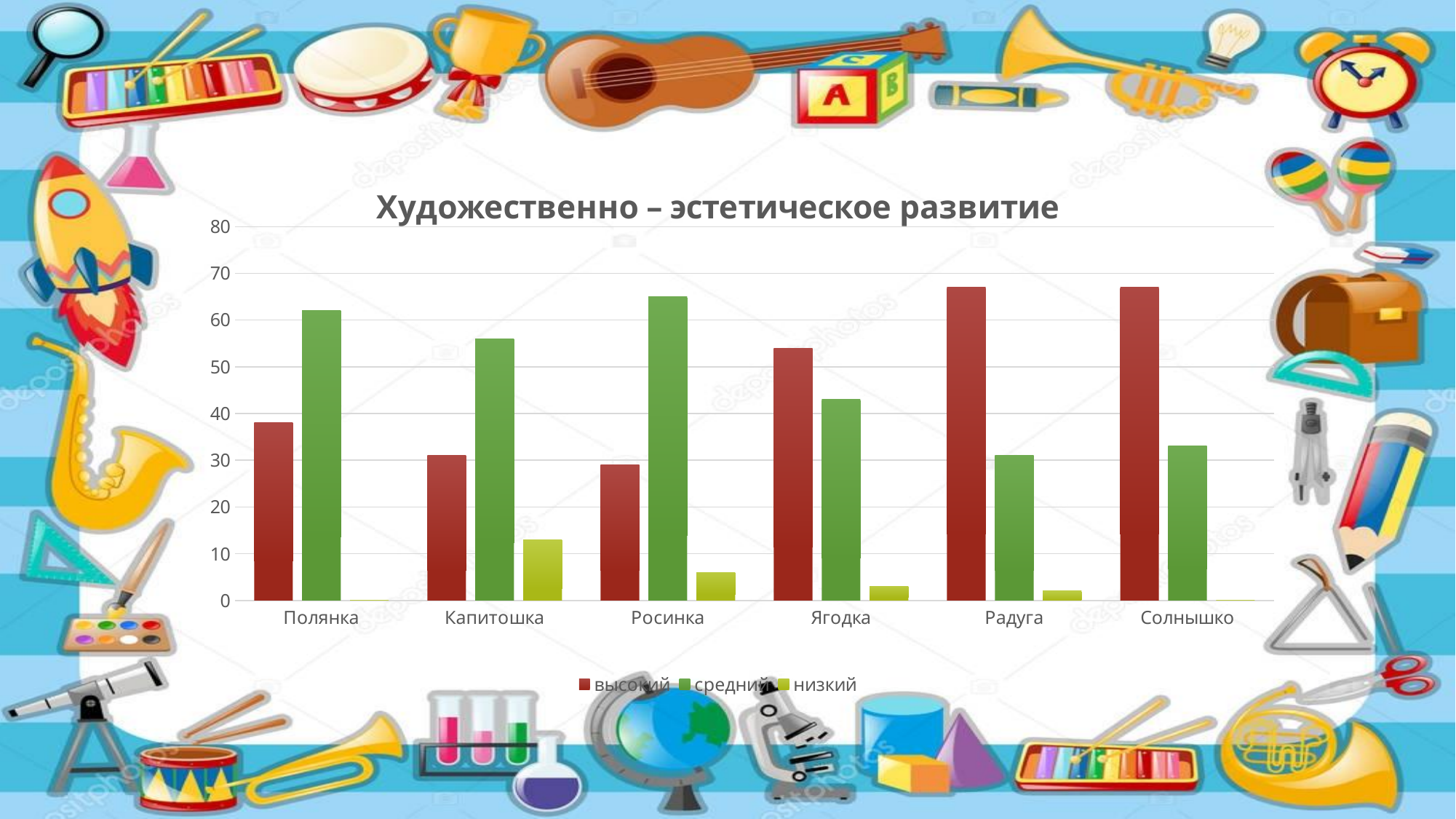
Is the value for высокий in Росинка greater or less than 40? less Is the value for высокий in Ягодка greater or less than 50? greater Is the value for средний in Росинка greater or less than 60? greater How many categories are shown on the x axis of the chart? 6 What kind of chart is shown on the slide? bar chart What is the title of the chart? Художественно – эстетическое развитие Which is larger: the value for высокий in Радуга or the value for высокий in Полянка? Радуга Which category has the highest value for the series низкий? Капитошка For Полянка, which is larger: the value for высокий or the value for средний? средний How many series does the legend of the chart list? 3